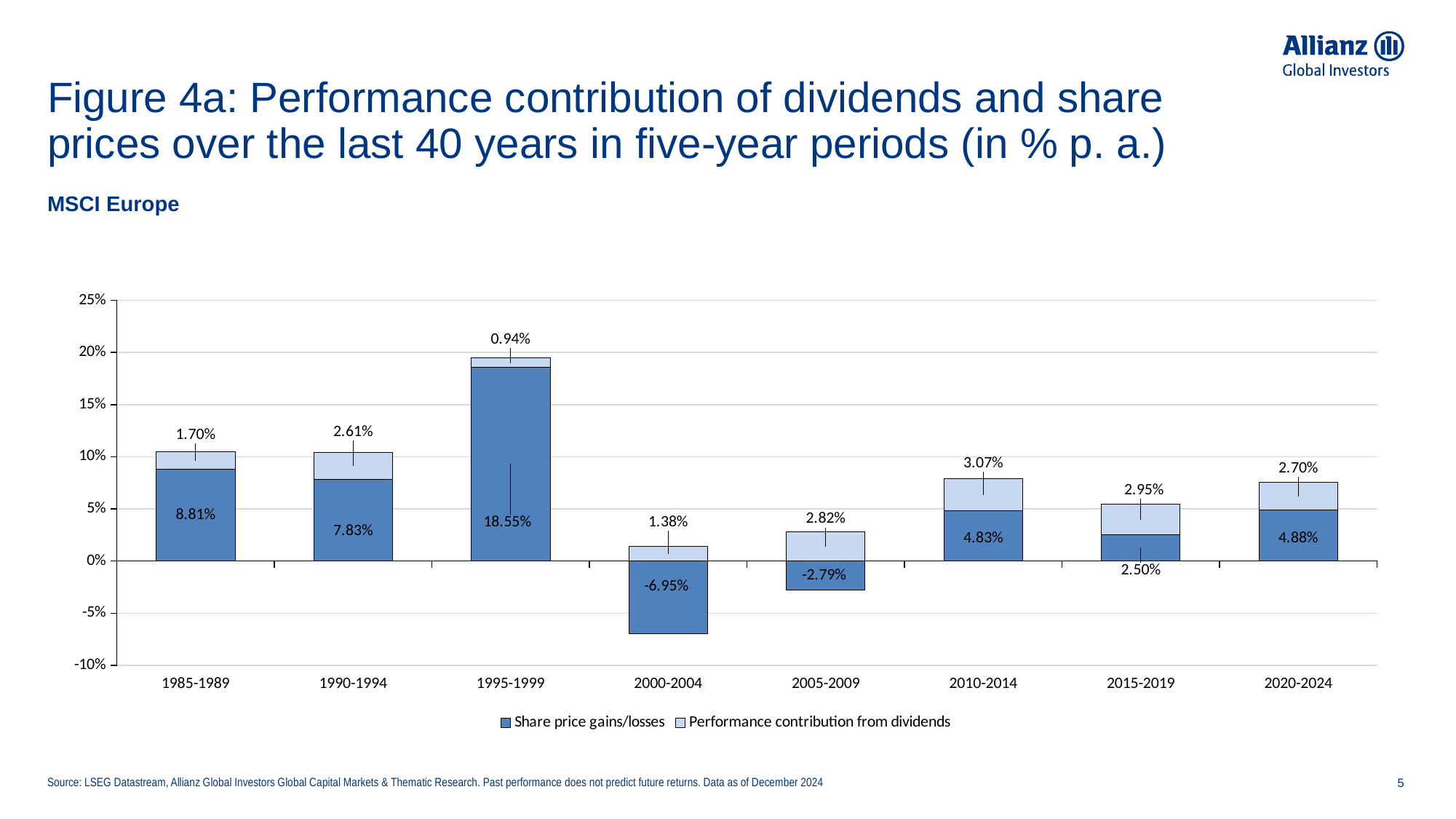
What is the difference between the share price gains/losses for 1985-1989 and 1990-1994? 0.98% What is the total of the stacked bar for 2010-2014? 7.90% What is the share price gains/losses value for 2000-2004? -6.95% How many five-year periods are shown on the x axis? 8 How many series does the legend list? 2 Which period has the lowest performance contribution from dividends? 1995-1999 What is the performance contribution from dividends for 2010-2014? 3.07% Which period has the highest share price gains/losses? 1995-1999 What kind of chart is shown on the slide? Stacked bar chart Which is larger: the performance contribution from dividends in 2015-2019 or in 2020-2024? 2015-2019 Which period has the lowest share price gains/losses? 2000-2004 What is the share price gains/losses value for 1995-1999? 18.55%